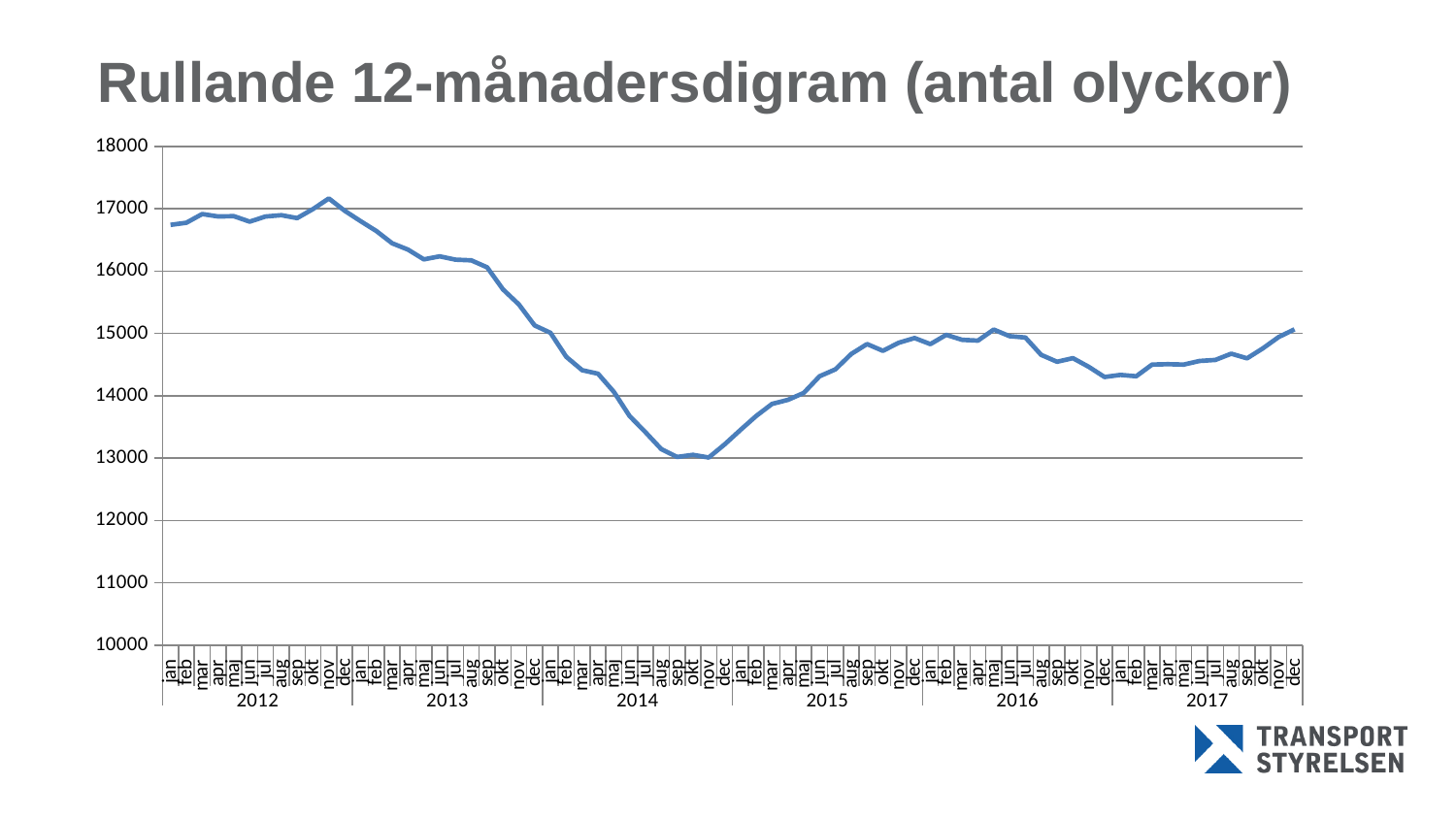
Which is larger, the value for jan 2012 or the value for jan 2015? jan 2012 Is the value for jan 2012 greater or less than 16000? greater What is the highest value shown on the y axis of the chart? 18000 What is the title of the chart? Rullande 12-månadersdigram (antal olyckor) In which year does the line reach its lowest point? 2014 In which year does the line reach its highest point? 2012 What kind of chart is shown on the slide? line chart Does the line rise or fall from jan 2013 to dec 2013? fall How many years are labelled along the x axis of the chart? 6 Is the value for dec 2016 greater or less than 15000? less Is the value for dec 2013 greater or less than 16000? less